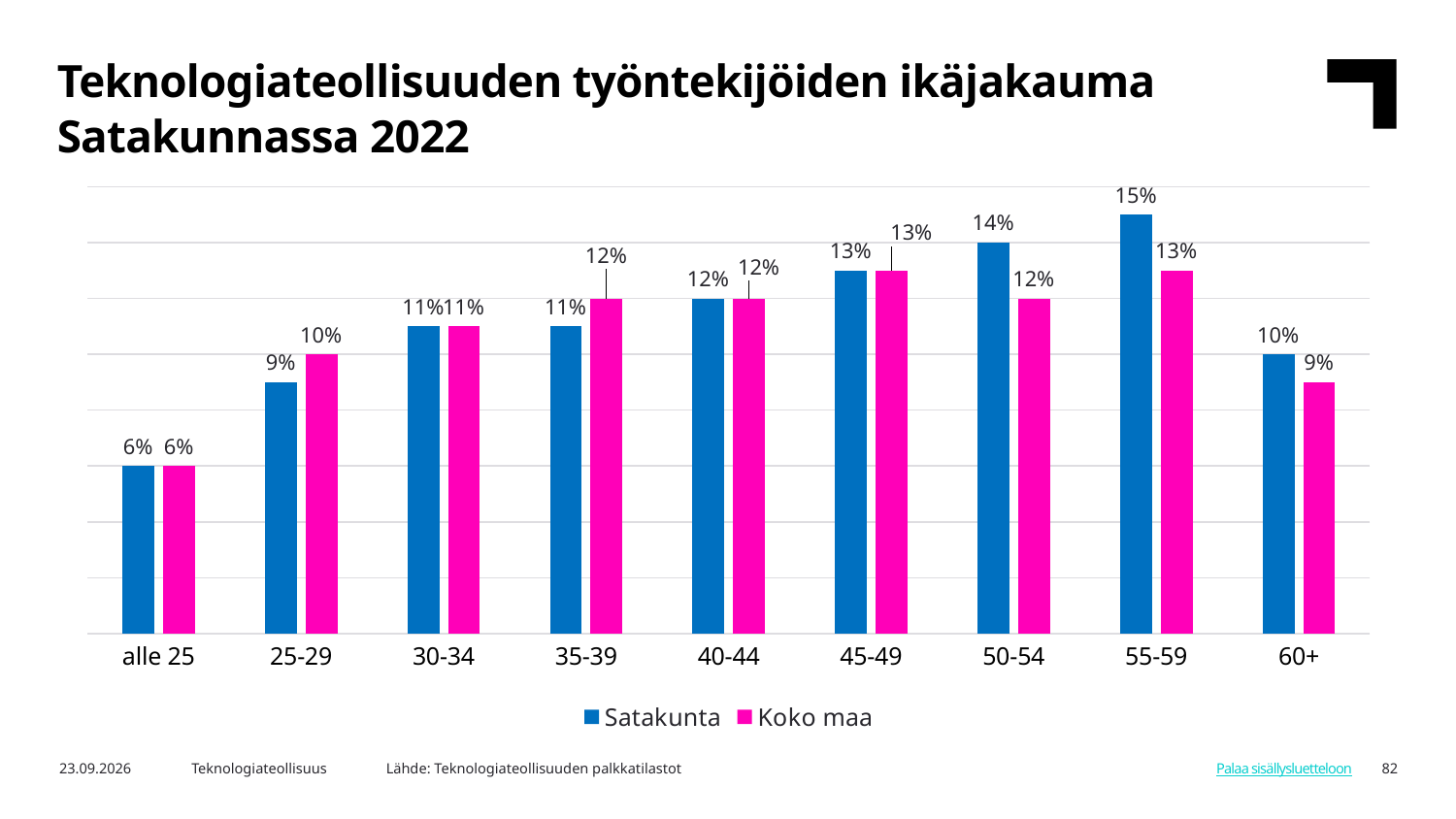
Which age group has the highest Satakunta value? 55-59 For the 50-54 age group, which is larger: the Satakunta value or the Koko maa value? Satakunta What is the difference between the Satakunta and Koko maa values for the 55-59 age group? 2% How many age groups are shown on the x axis? 9 What is the Satakunta value for the 50-54 age group? 14% How many series does the legend list? 2 What is the Satakunta value for the 55-59 age group? 15% Which age group has the lowest Koko maa value? alle 25 What kind of chart is shown on the slide? Bar chart Which series is shown in pink in the legend? Koko maa What is the Koko maa value for the 25-29 age group? 10% What is the Koko maa value for the 60+ age group? 9%